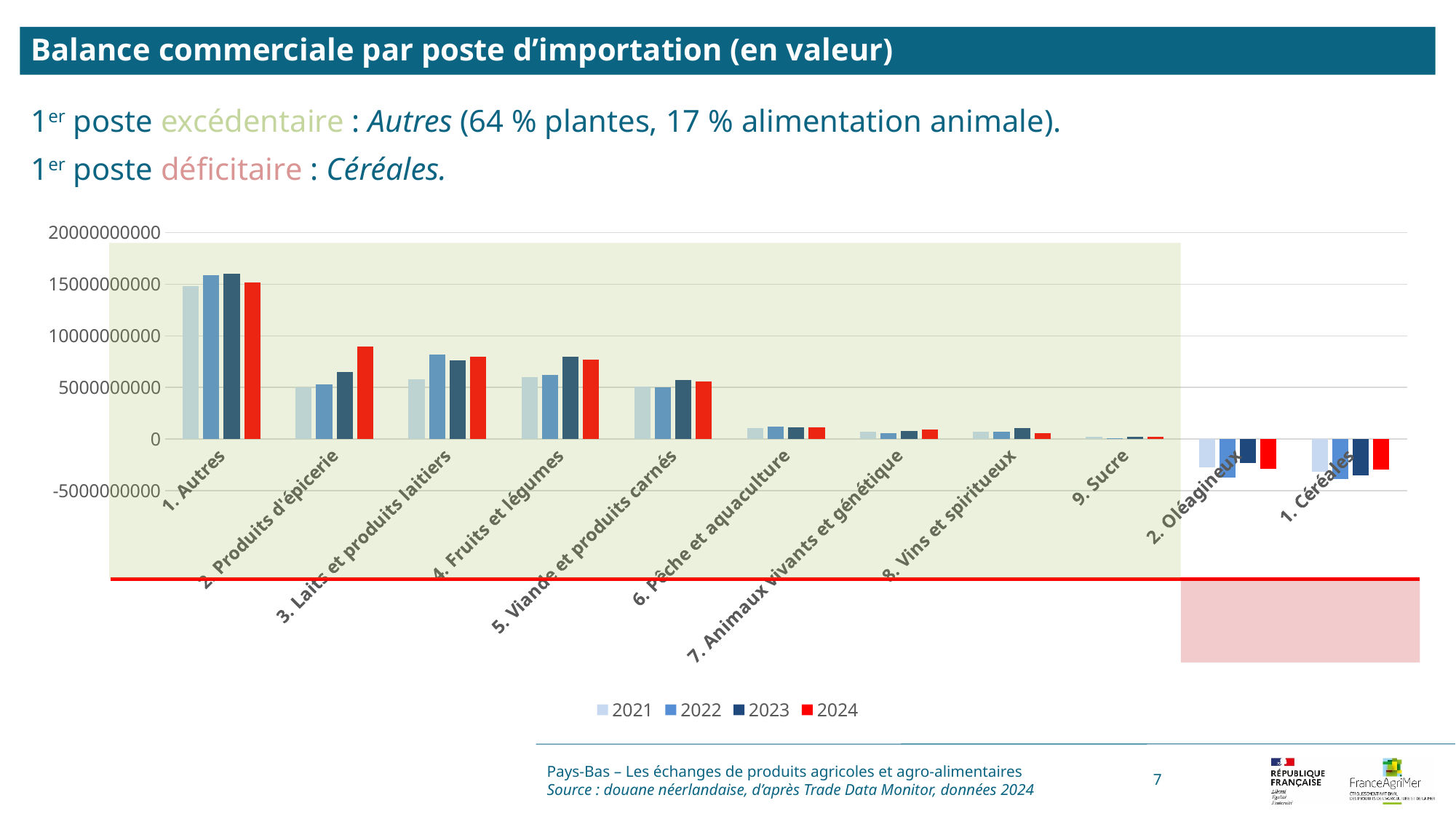
Is the 2024 value for '1. Autres' greater or less than 10000000000? greater How many series does the chart legend list? 4 Which category has the highest 2024 value in the chart? 1. Autres For the category '2. Produits d'épicerie', which year has the highest bar? 2024 How many categories (import items) are shown on the x axis of the chart? 11 Is the 2024 value for '3. Laits et produits laitiers' greater or less than 5000000000? greater Which is larger: the 2023 value for '4. Fruits et légumes' or the 2023 value for '6. Pêche et aquaculture'? 4. Fruits et légumes Is the 2023 value for '9. Sucre' greater or less than 5000000000? less Do the 2024 values generally rise or fall from left to right along the x axis? fall What kind of chart is shown on the slide? bar chart What is the title of the slide containing the chart? Balance commerciale par poste d’importation (en valeur)